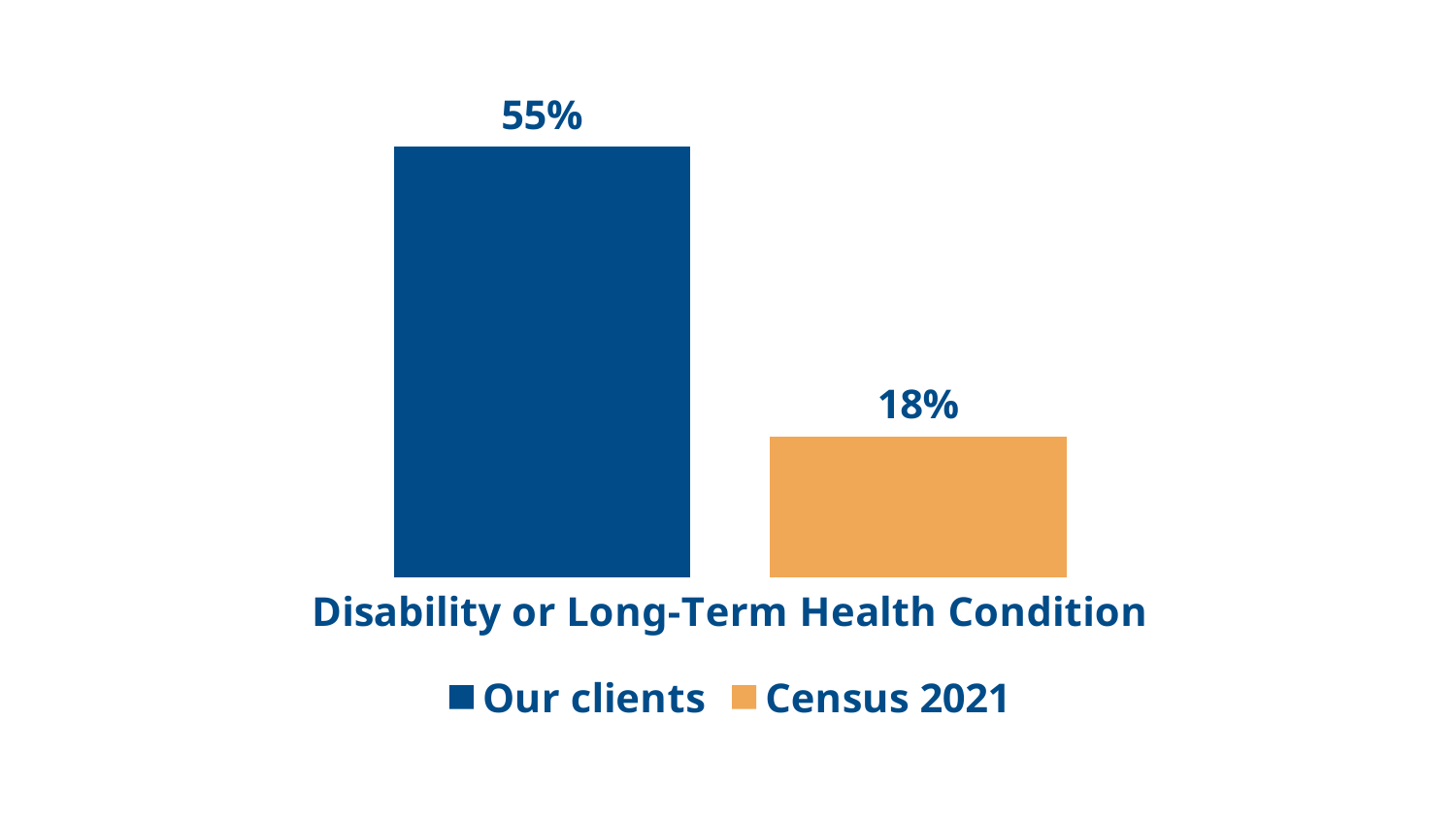
Which series is shown in orange? Census 2021 Is the value for Our clients larger or smaller than the value for Census 2021? larger What is the value for Census 2021 for Disability or Long-Term Health Condition? 18% What kind of chart is shown on the slide? bar chart What is the difference between the Our clients value and the Census 2021 value? 37% What is the category label shown below the bars? Disability or Long-Term Health Condition How many categories are shown on the x axis? 1 How many series does the legend list? 2 Which series has the higher value for Disability or Long-Term Health Condition? Our clients What is the value for Our clients for Disability or Long-Term Health Condition? 55% Which series has the lower value for Disability or Long-Term Health Condition? Census 2021